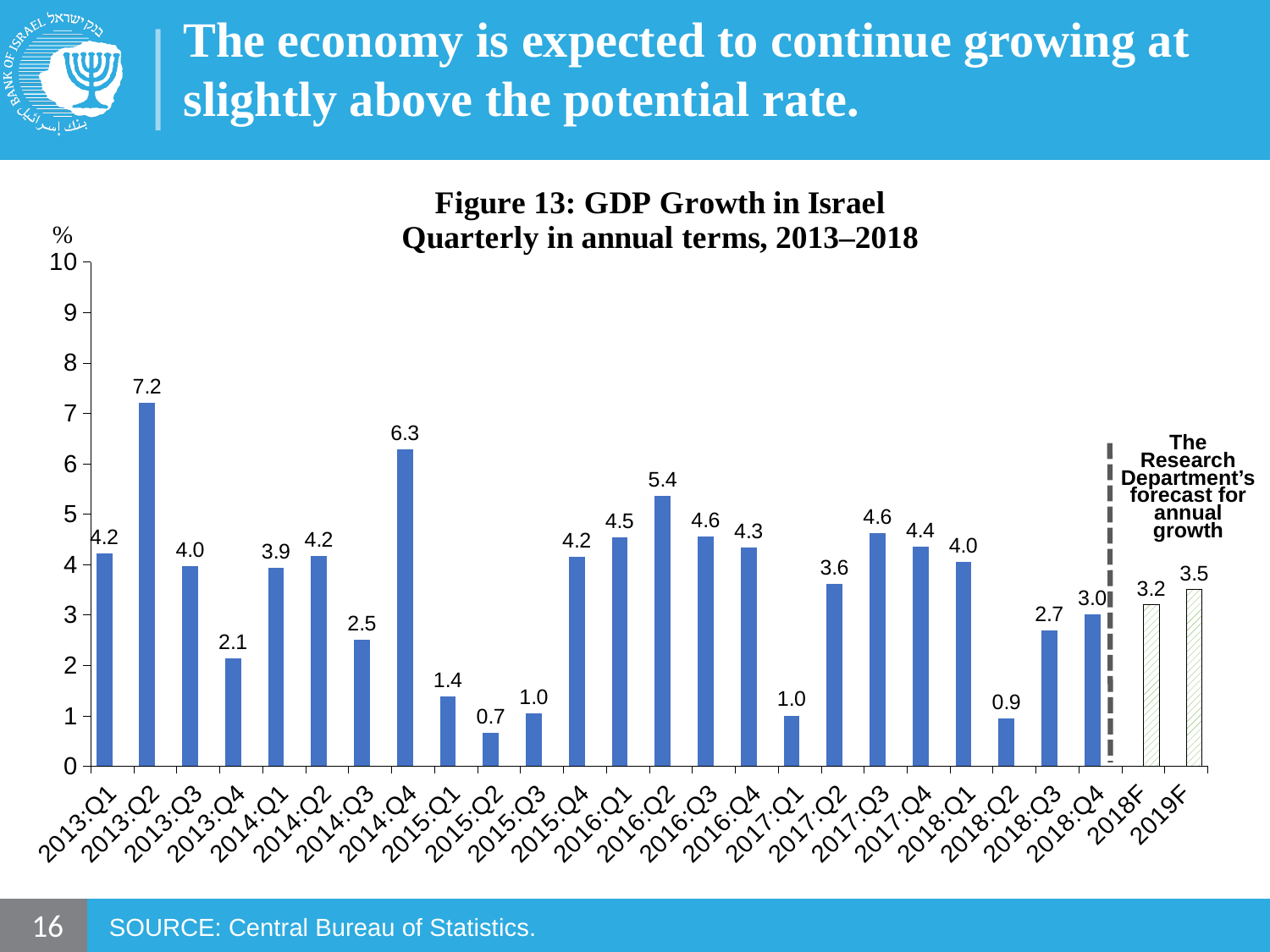
Which quarter has the lowest GDP growth value? 2015:Q2 What is the Research Department's forecast for annual growth in 2019 (2019F)? 3.5 What kind of chart is Figure 13? bar chart What is the GDP growth value for 2018:Q2? 0.9 What is the difference between the GDP growth values for 2016:Q2 and 2016:Q1? 0.9 What is the GDP growth value for 2014:Q4? 6.3 Which quarter has the highest GDP growth value? 2013:Q2 Which is larger, the GDP growth value for 2017:Q2 or for 2018:Q4? 2017:Q2 What is the title of the figure on the slide? Figure 13: GDP Growth in Israel Quarterly in annual terms, 2013–2018 What is the GDP growth value for 2013:Q2? 7.2 Is the GDP growth value for 2014:Q4 greater or less than 5? greater How many bars are plotted in the chart, including the two forecast bars? 26